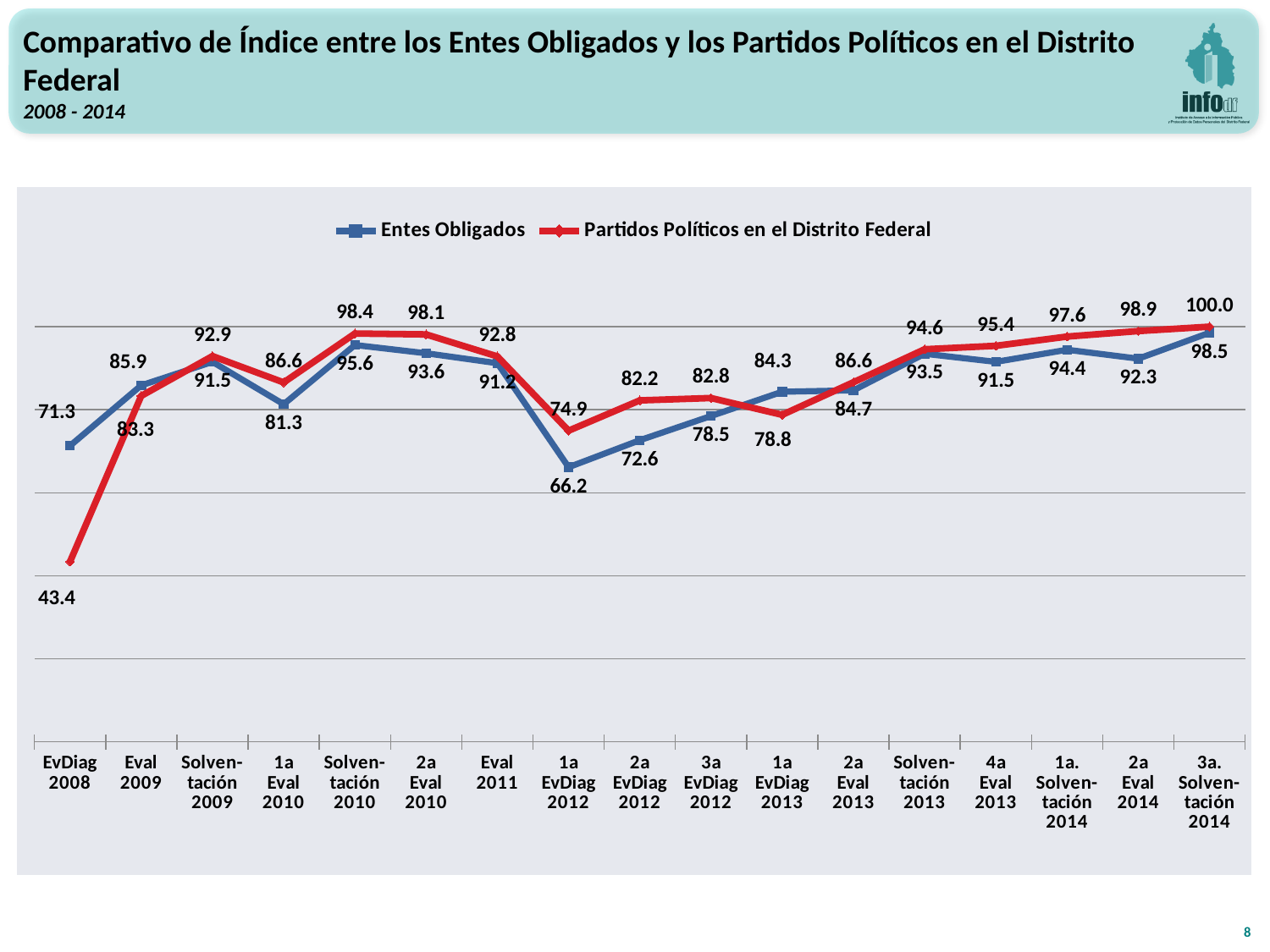
At which category is the Partidos Políticos en el Distrito Federal series lowest? EvDiag 2008 What is the value for Partidos Políticos en el Distrito Federal at EvDiag 2008? 43.4 How many categories are shown on the x axis? 17 What type of chart is shown on the slide? line chart What is the value for Entes Obligados at 1a EvDiag 2012? 66.2 At which category is the Entes Obligados series highest? 3a. Solventación 2014 What is the difference between Entes Obligados and Partidos Políticos en el Distrito Federal at EvDiag 2008? 27.9 How many series does the legend list? 2 Which series is drawn in red? Partidos Políticos en el Distrito Federal Which series has the larger value at 1a EvDiag 2013? Entes Obligados What is the value for Partidos Políticos en el Distrito Federal at 3a. Solventación 2014? 100.0 What is the value for Entes Obligados at Solventación 2010? 95.6